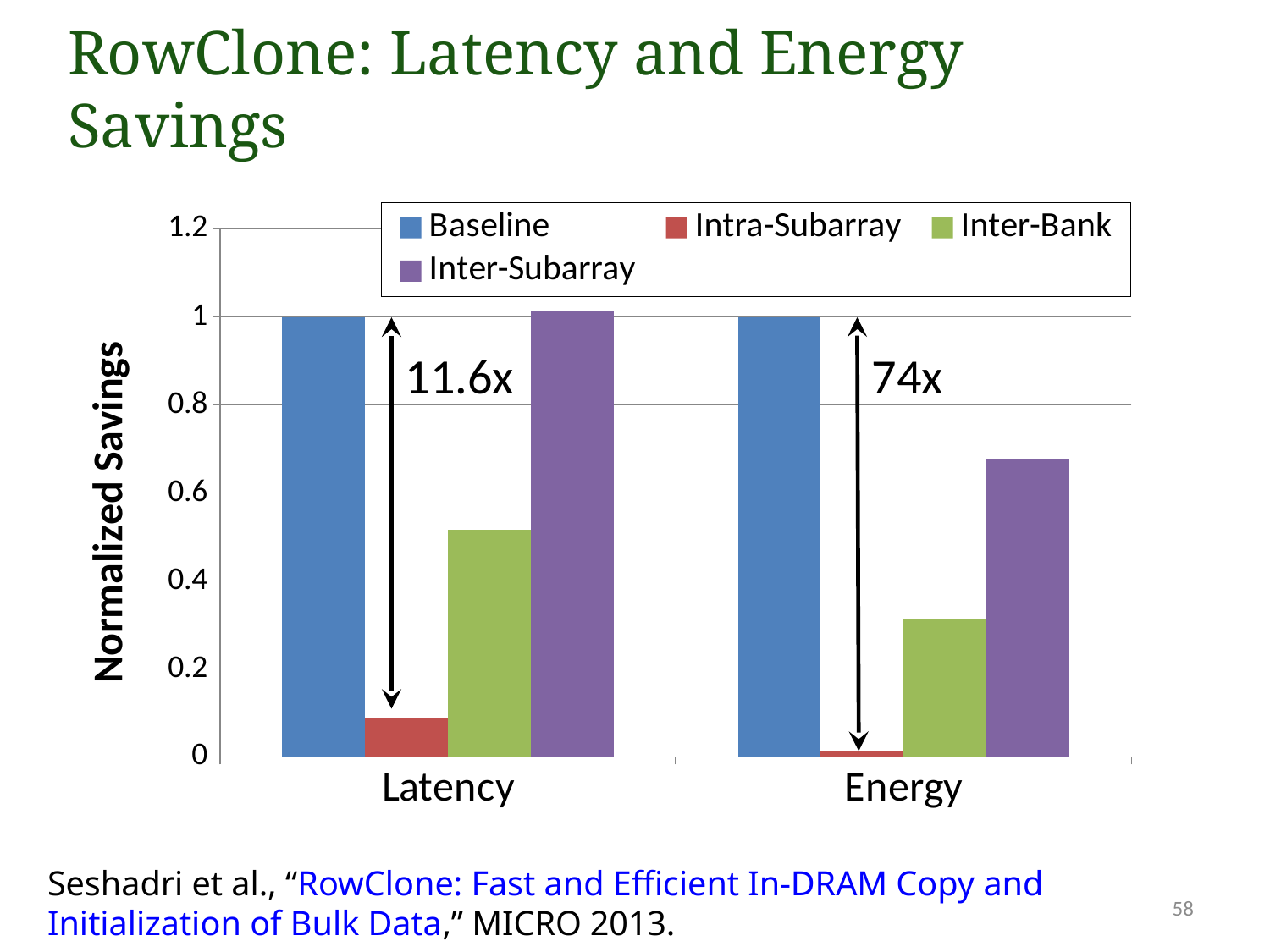
Which series has the lowest value for Energy? Intra-Subarray What is the title of the y axis? Normalized Savings Is the Intra-Subarray value for Latency greater or less than 0.2? less Is the Inter-Bank value for Energy greater or less than 0.4? less What is the Baseline value for Energy? 1 What type of chart is shown on the slide? bar chart How many series does the legend list? 4 How many categories are shown on the x axis? 2 Which is larger: the Inter-Subarray value for Latency or the Inter-Subarray value for Energy? Latency What is the Baseline value for Latency? 1 Is the Inter-Bank value for Latency greater or less than 0.4? greater Which series has the lowest value for Latency? Intra-Subarray